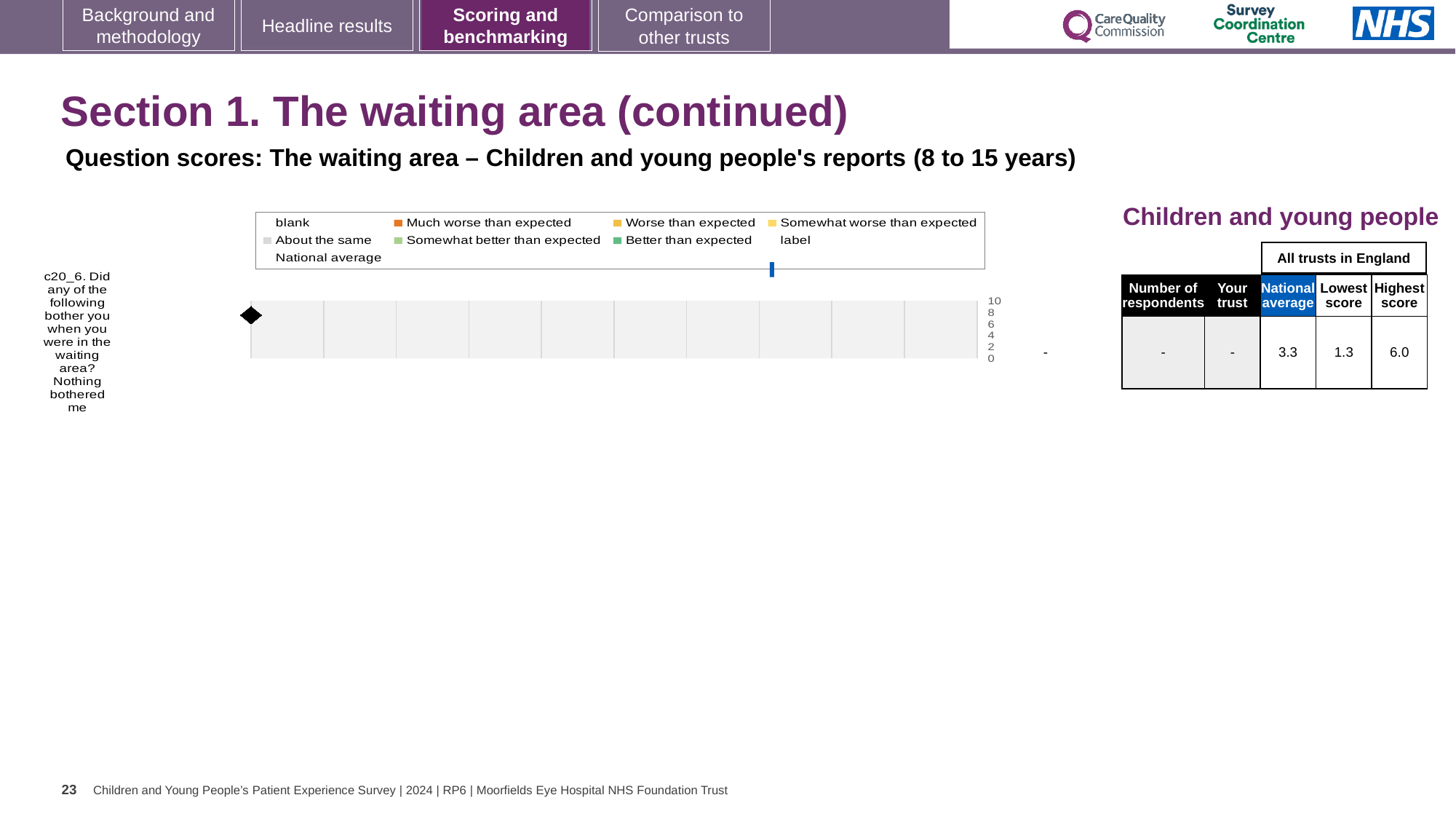
In the table next to the chart, what is the Lowest score across all trusts in England? 1.3 In the table next to the chart, what is the difference between the Highest score and the Lowest score? 4.7 What kind of chart is shown on the slide? bar chart How many question categories are plotted on the chart's vertical axis? 1 In the table next to the chart, what value is shown for Your trust? - What is the highest value shown on the chart's numeric axis? 10 In the table next to the chart, is the National average greater or less than the Highest score? less In the table next to the chart, what is the National average score for question c20_6? 3.3 In the table next to the chart, what is the Highest score across all trusts in England? 6.0 Which question is labelled on the chart's category axis? c20_6. Did any of the following bother you when you were in the waiting area? Nothing bothered me